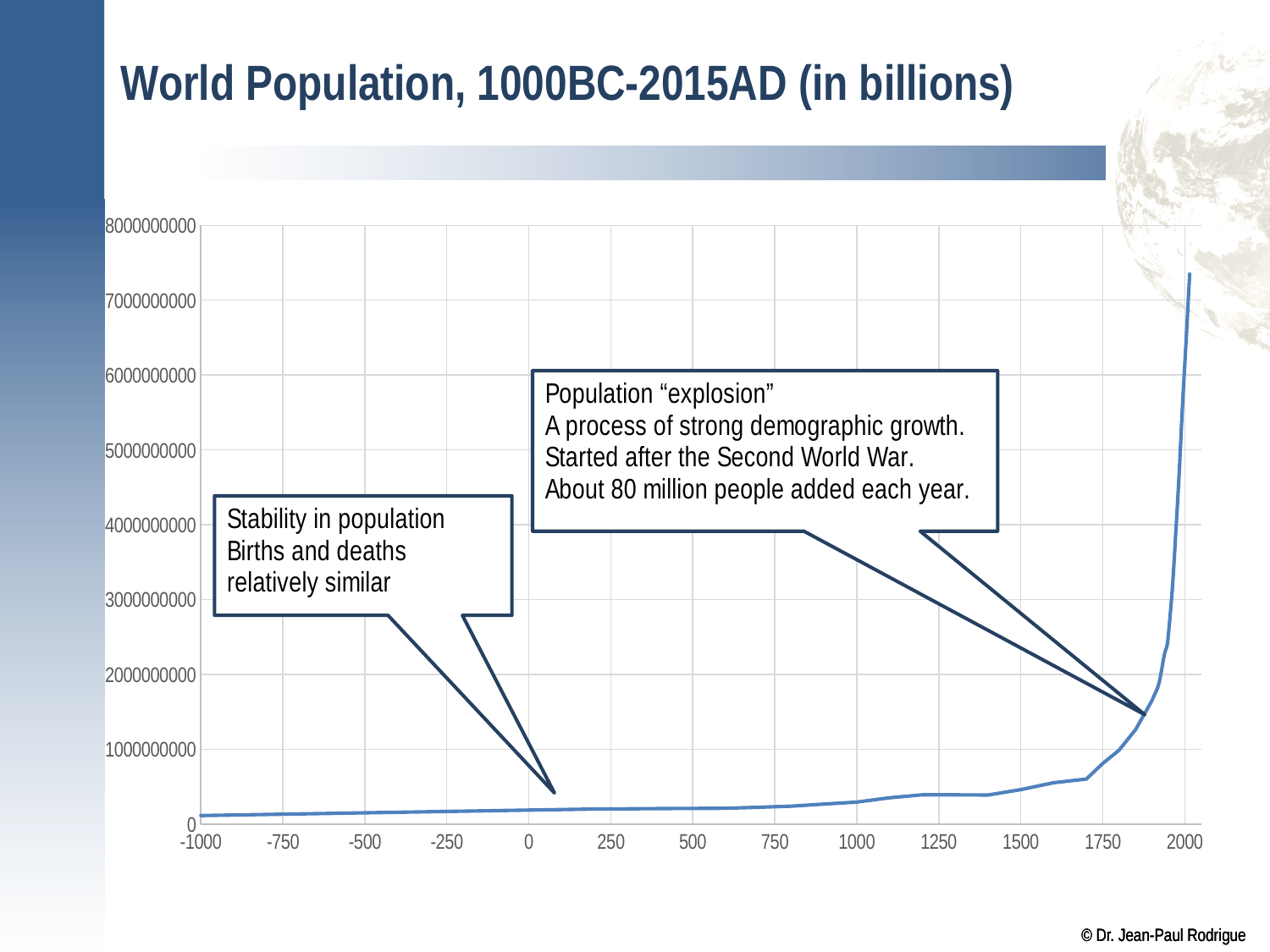
What is the highest value shown on the y axis? 8000000000 Which is larger, the population value at 1500 or at 2000? 2000 Does world population rise or fall overall from -1000 to 2000 along the x axis? rise What is the title of the chart on the slide? World Population, 1000BC-2015AD (in billions) At which end of the x axis does the population reach its maximum? the right end (around 2000) Is the value for the year 1000 greater or less than 1000000000? less What kind of chart is shown on the slide? line chart Is the value for the year 1750 greater or less than 1000000000? less How many data series (lines) are plotted on the chart? 1 How many tick labels are shown on the x axis? 13 Is the value for the year 0 greater or less than 1000000000? less